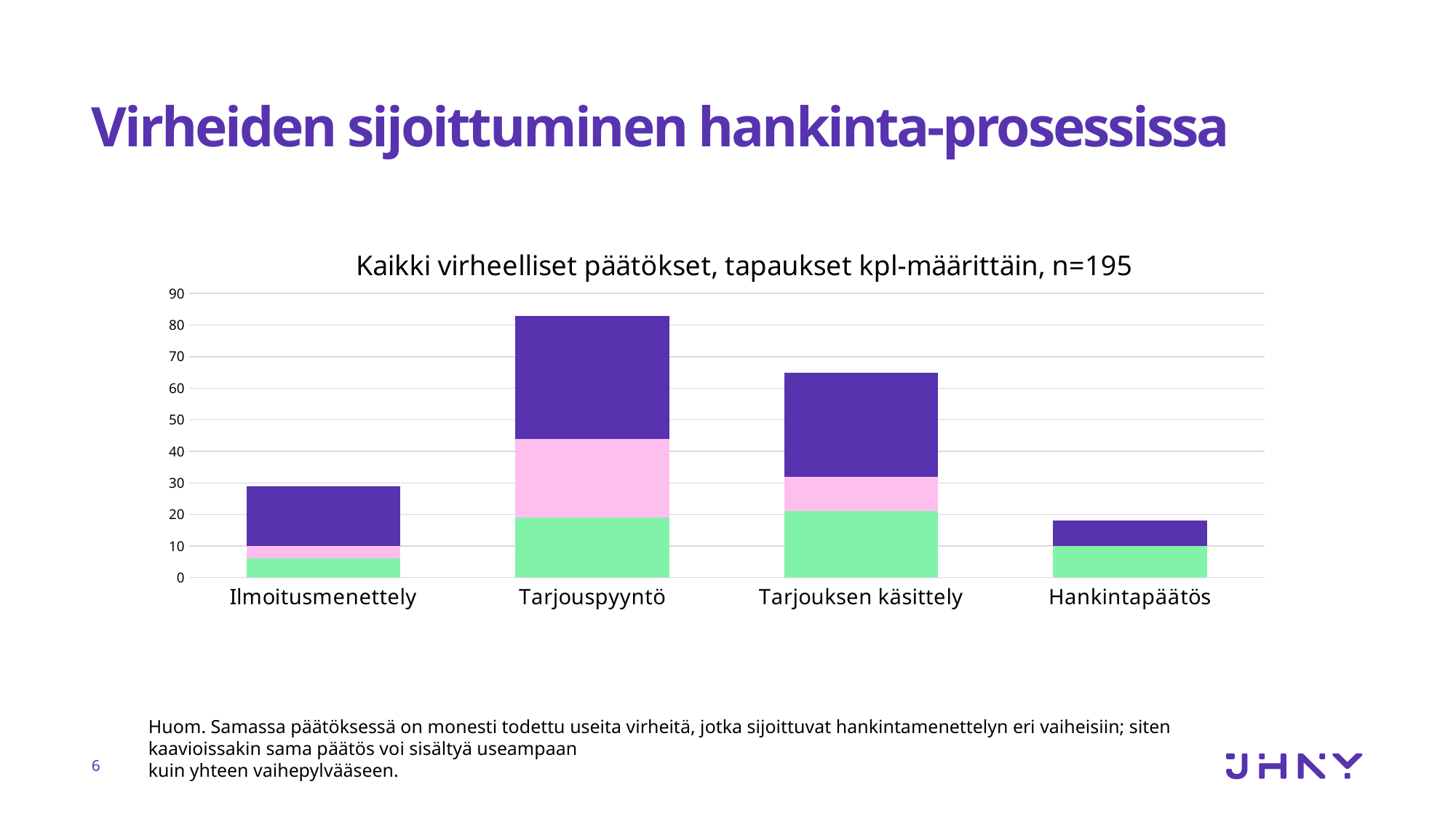
Which category has the shortest stacked bar? Hankintapäätös Is the total value for Ilmoitusmenettely greater or less than 40? less Is the total value for Tarjouspyyntö greater or less than 70? greater Which has a taller stacked bar, Tarjouksen käsittely or Ilmoitusmenettely? Tarjouksen käsittely What is the title of the chart? Kaikki virheelliset päätökset, tapaukset kpl-määrittäin, n=195 Is the total value for Tarjouksen käsittely greater or less than 60? greater What is the highest value shown on the y axis of the chart? 90 Which category has the tallest stacked bar? Tarjouspyyntö Which has a taller stacked bar, Ilmoitusmenettely or Hankintapäätös? Ilmoitusmenettely How many categories are shown on the x axis of the chart? 4 What kind of chart is shown on the slide? Stacked bar chart